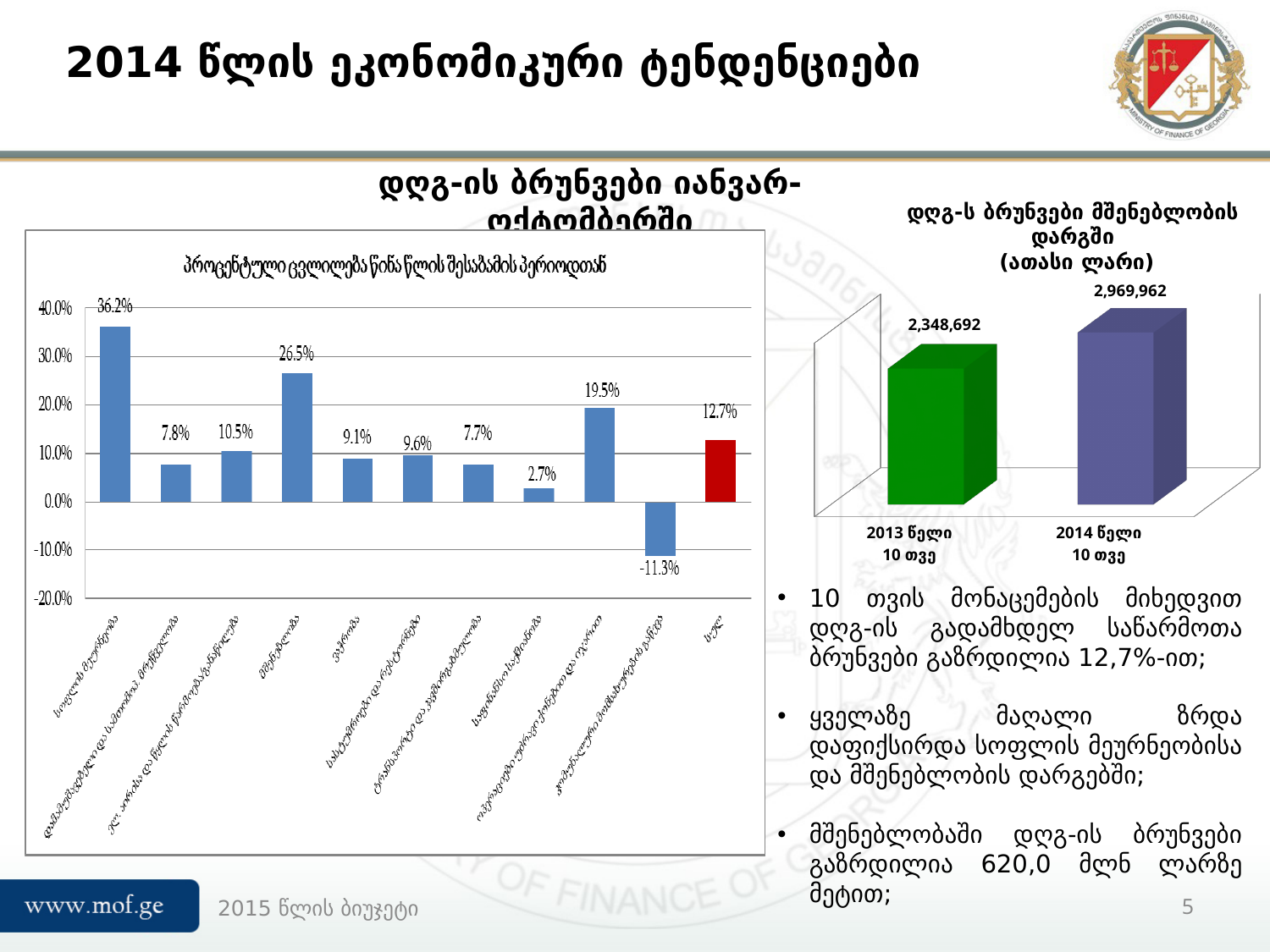
In the left chart, what is the lowest value shown? -11.3% What type of chart is the right chart (VAT turnover in construction)? Bar chart In the left chart, what is the value of the first bar (სოფლის მეურნეობა)? 36.2% In the right chart, what is the value for 2013 წელი 10 თვე? 2,348,692 In the left chart, what is the difference between the value for სოფლის მეურნეობა (36.2%) and the value for მშენებლობა (26.5%)? 9.7 percentage points In the left chart, what is the highest value shown? 36.2% In the left chart, how many bars are plotted? 11 In the right chart, which year has the larger value, 2013 or 2014? 2014 In the right chart (VAT turnover in construction, thousand GEL), what is the value for 2014 წელი 10 თვე? 2,969,962 In the left chart, what is the value of the bar for მშენებლობა? 26.5% In the left chart (VAT turnover January–October), what is the value of the red bar labelled სულ? 12.7% In the left chart, how many bars have a negative value? 1